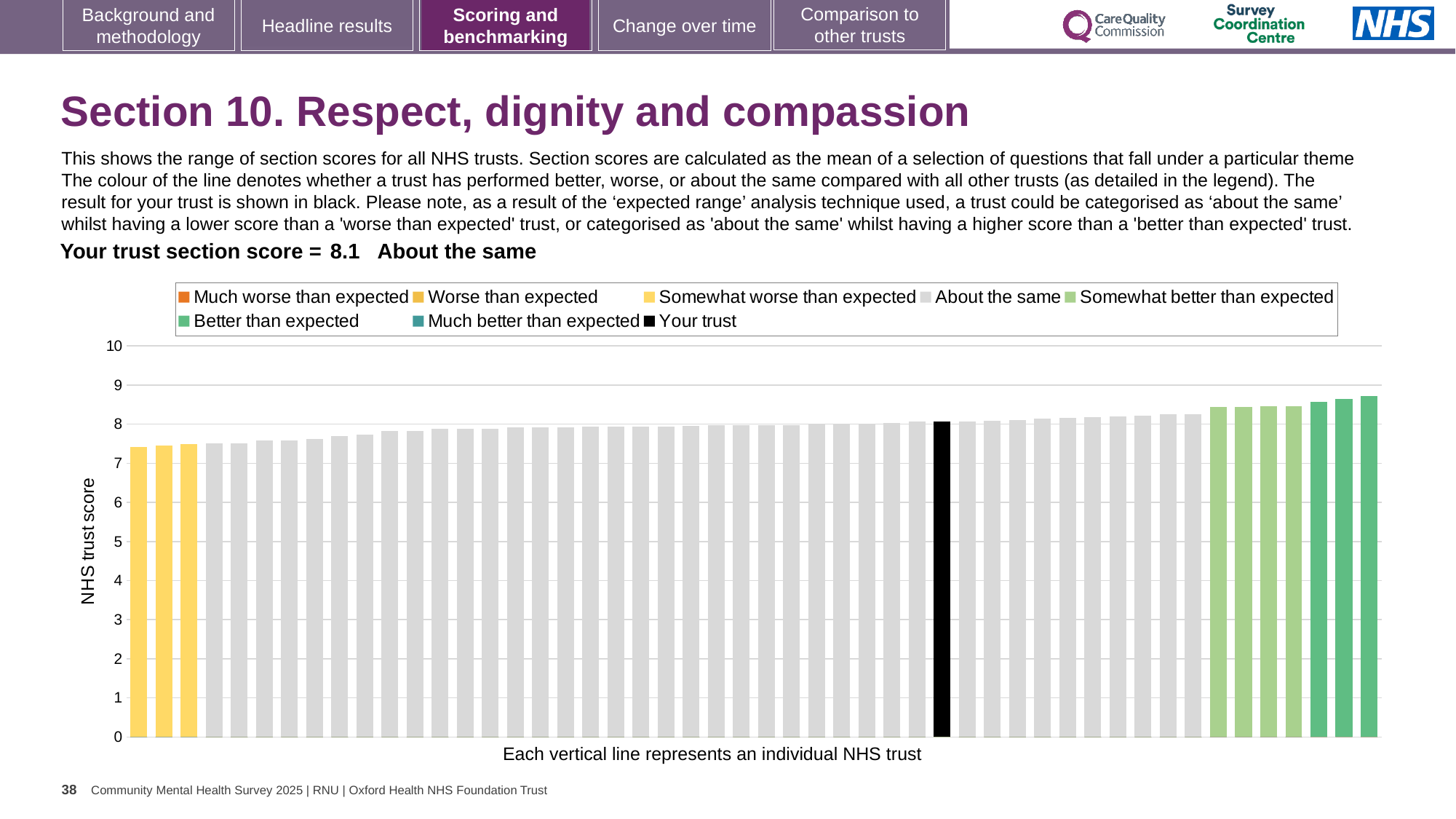
Is the value of the highest bar greater or less than 9? less Which category is your trust placed in for this section? About the same What is the label on the vertical axis of the chart? NHS trust score How many bars are coloured 'Somewhat worse than expected' (yellow)? 3 How many bars are coloured 'Better than expected' (dark green)? 3 What kind of chart is shown on the slide? bar chart What is your trust's section score for Section 10, Respect, dignity and compassion? 8.1 How many entries does the chart legend list? 8 Is the value of the lowest bar greater or less than 7? greater Is the value for your trust greater or less than 8? greater What colour is the bar representing your trust? black Do the bar values rise or fall from left to right along the x axis? rise